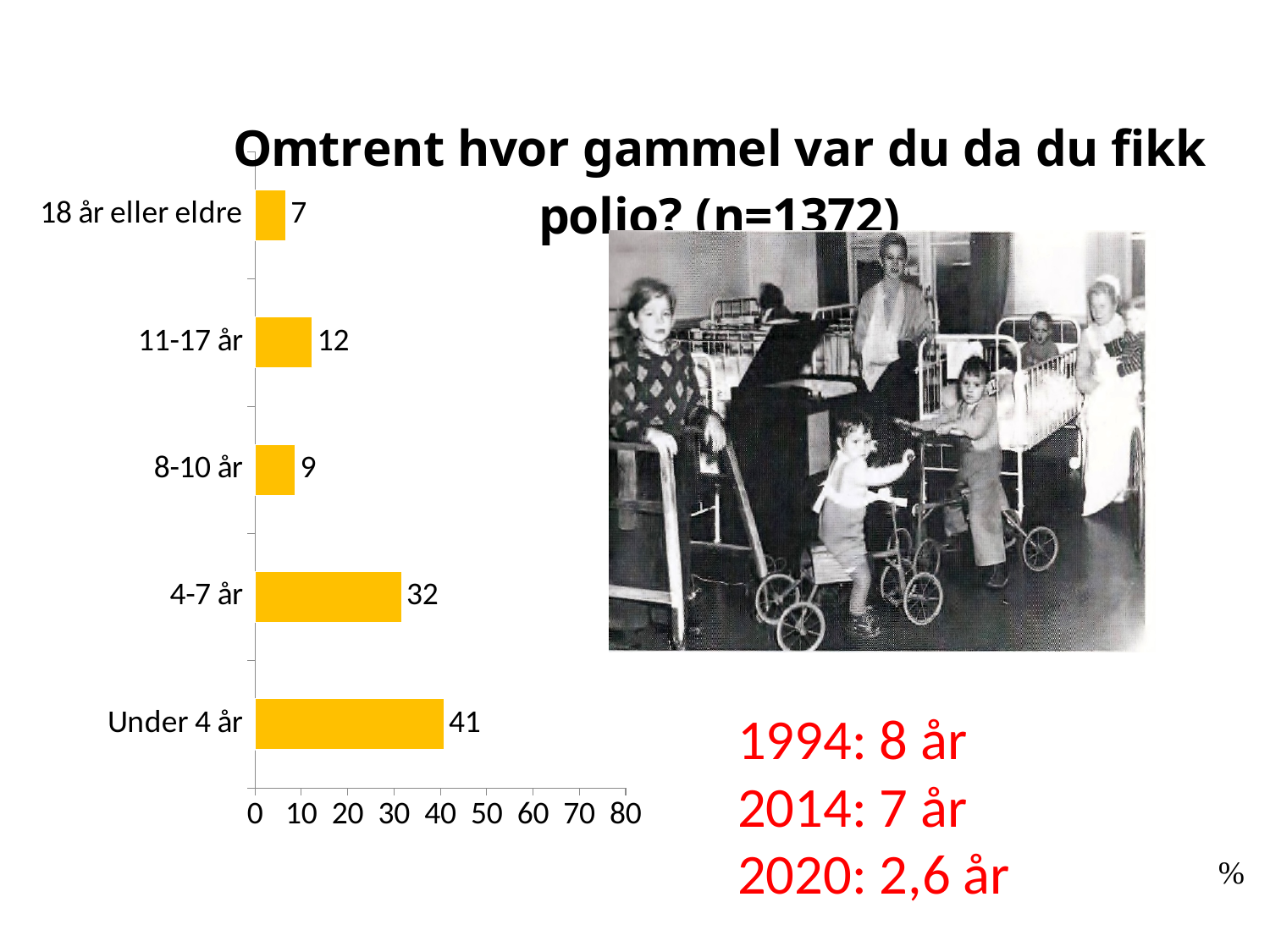
Which is larger, the value for '11-17 år' or the value for '8-10 år'? 11-17 år Which category has the lowest value? 18 år eller eldre What is the maximum value shown on the horizontal axis? 80 What is the value for '11-17 år'? 12 What is the value for '4-7 år'? 32 What is the value for '8-10 år'? 9 What is the value for 'Under 4 år'? 41 Which category has the highest value? Under 4 år How many categories are shown in the chart? 5 What is the difference between the values for 'Under 4 år' and '4-7 år'? 9 What kind of chart is shown on the slide? Bar chart What is the value for '18 år eller eldre'? 7